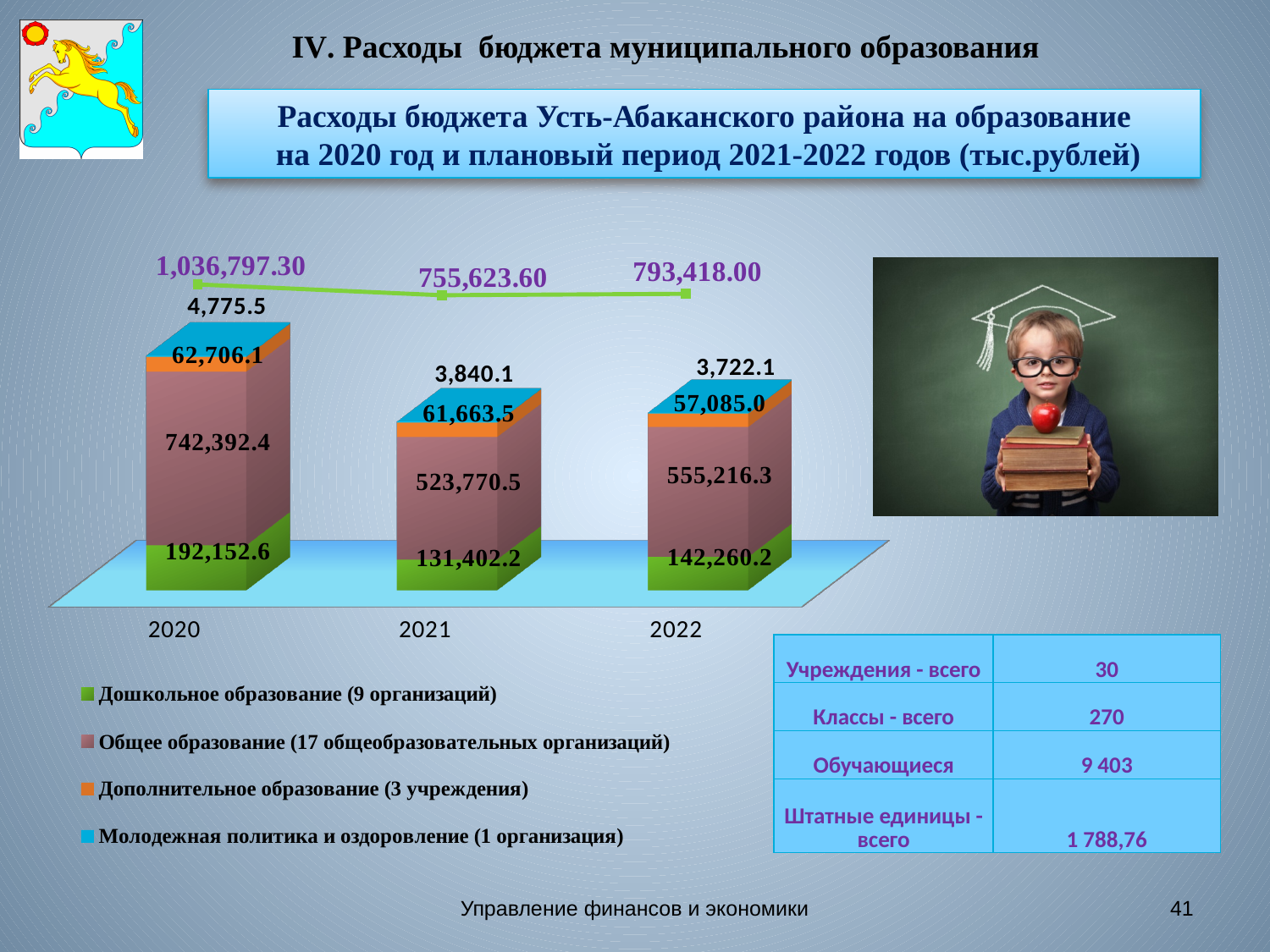
What is the purple value printed on the line above the 2021 bar? 755,623.60 Which year has the larger value for Дополнительное образование, 2021 or 2022? 2021 In which year is the value for Общее образование the highest? 2020 How many series does the chart legend list? 4 In which year is the value for Дошкольное образование the lowest? 2021 What kind of chart is used to show the education budget expenditures by year? Stacked bar chart What is the difference between the Общее образование values for 2020 and 2021? 218,621.9 What is the value for Общее образование in 2021? 523,770.5 What is the value for Молодежная политика и оздоровление in 2020? 4,775.5 What is the value for Дошкольное образование in 2022? 142,260.2 Which legend entry is shown in green? Дошкольное образование (9 организаций) How many years (categories) are shown on the x axis of the chart? 3